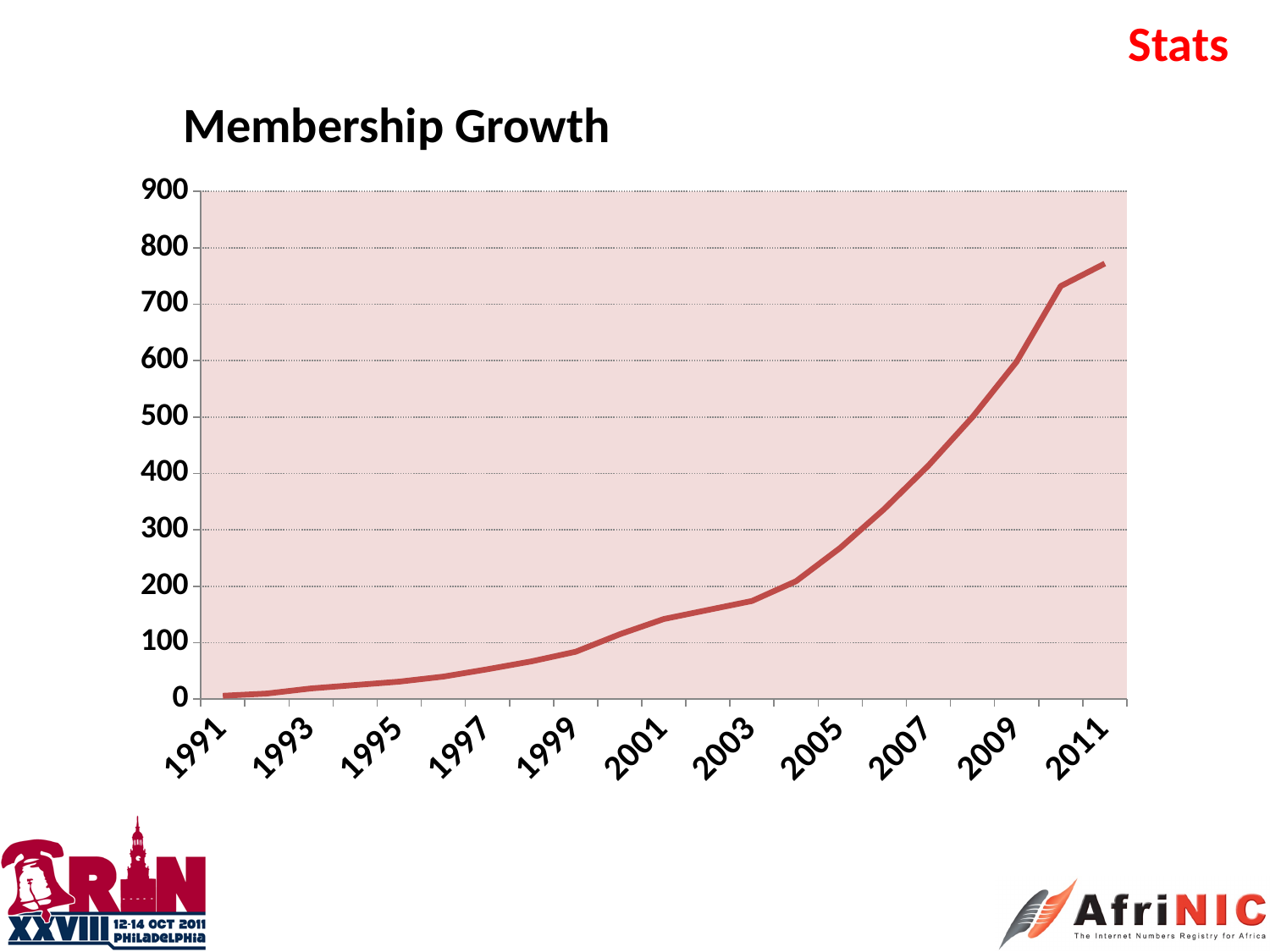
What kind of chart is shown on the slide? line chart Which year has the highest value in the Membership Growth chart? 2011 What is the title of the chart? Membership Growth Is the value for 2011 greater or less than 800? less Do the values in the Membership Growth chart rise or fall from 1991 to 2011? rise Which year has the larger value, 2005 or 2009? 2009 Is the value for 2003 greater or less than 200? less Which year has the lowest value in the Membership Growth chart? 1991 Is the value for 2011 greater or less than 700? greater How many year labels are shown on the x axis of the chart? 11